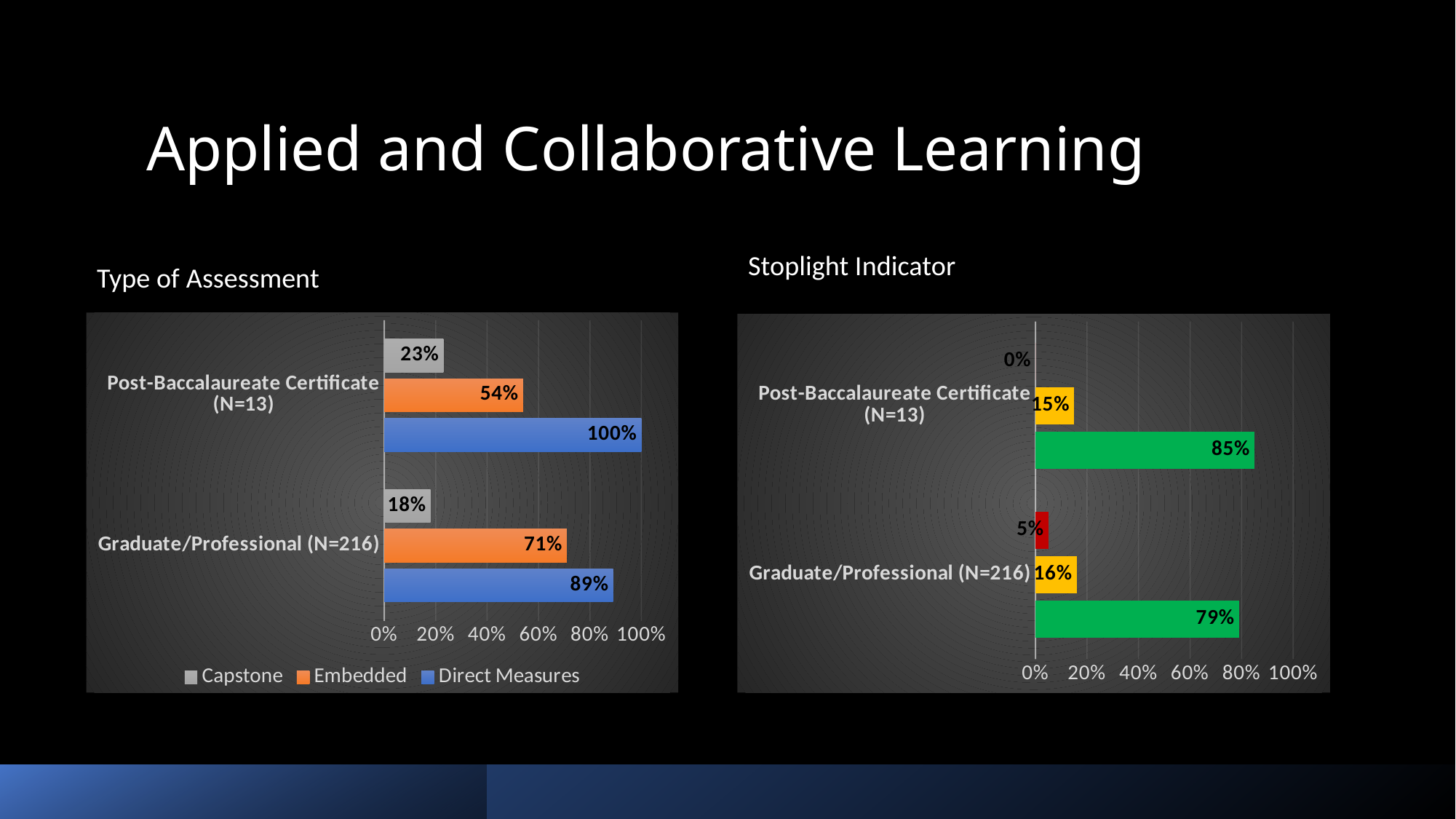
What type of chart is the Stoplight Indicator chart? Bar chart In the Type of Assessment chart, what is the difference between the Direct Measures values for Post-Baccalaureate Certificate (N=13) and Graduate/Professional (N=216)? 11% In the Type of Assessment chart, what is the Embedded value for Graduate/Professional (N=216)? 71% In the Type of Assessment chart, which series has the lowest value for Graduate/Professional (N=216)? Capstone In the Stoplight Indicator chart, what is the difference between the green bar values for Post-Baccalaureate Certificate (N=13) and Graduate/Professional (N=216)? 6% In the Stoplight Indicator chart, what is the value of the red bar for Post-Baccalaureate Certificate (N=13)? 0% In the Type of Assessment chart, how many series does the legend list? 3 How many categories are shown in the Stoplight Indicator chart? 2 In the Type of Assessment chart, which is larger: the Embedded value for Post-Baccalaureate Certificate (N=13) or for Graduate/Professional (N=216)? Graduate/Professional (N=216) In the Stoplight Indicator chart, what is the value of the green bar for Graduate/Professional (N=216)? 79% In the Type of Assessment chart, what is the Capstone value for Post-Baccalaureate Certificate (N=13)? 23% In the Type of Assessment chart, what is the Direct Measures value for Post-Baccalaureate Certificate (N=13)? 100%